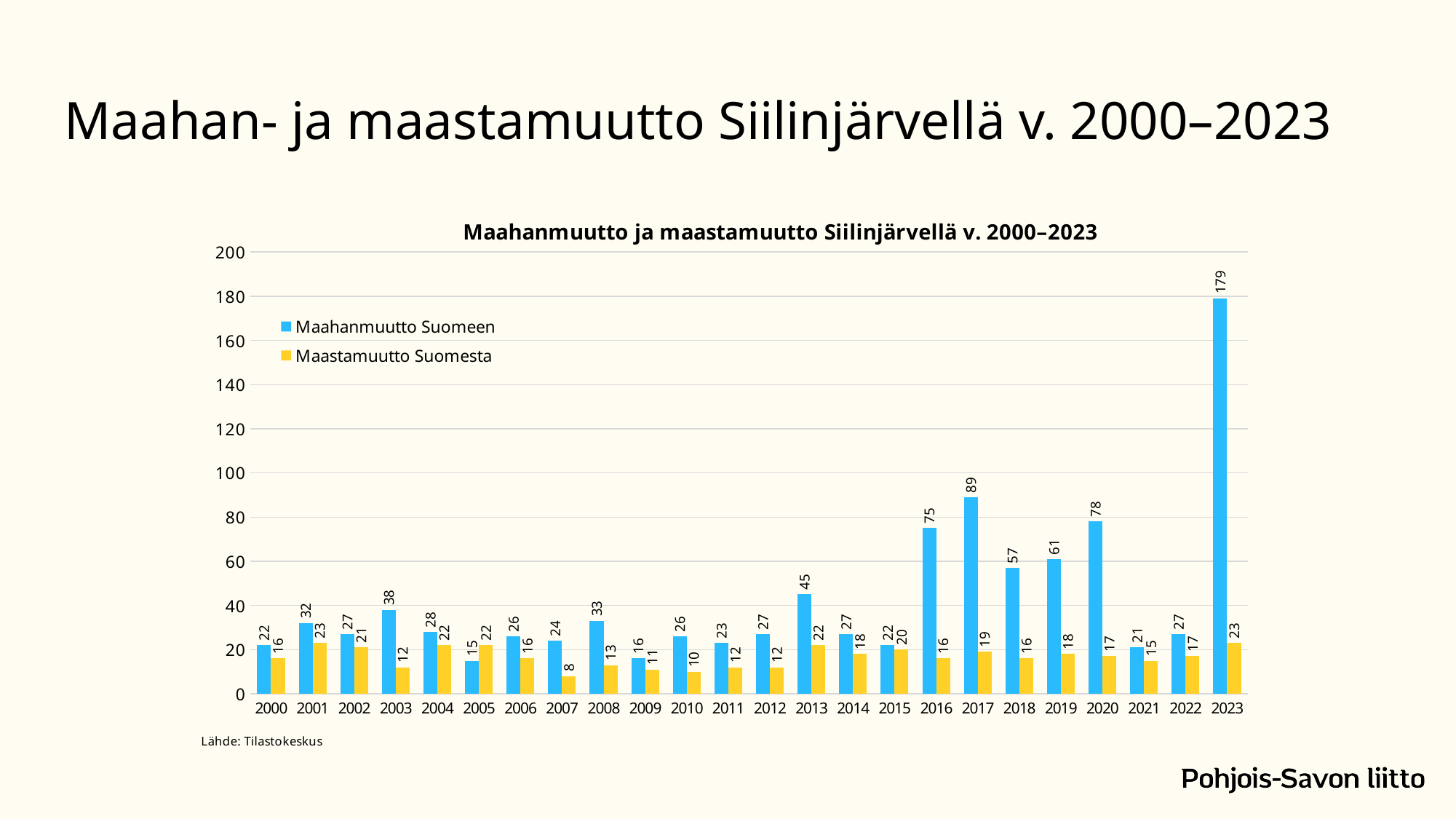
What is the difference between Maahanmuutto Suomeen and Maastamuutto Suomesta in 2023? 156 How many years are shown on the x axis? 24 Which year has the highest value for Maahanmuutto Suomeen? 2023 Which year has the lowest value for Maahanmuutto Suomeen? 2005 What is the value of Maastamuutto Suomesta for 2007? 8 What is the value of Maahanmuutto Suomeen for 2017? 89 How many series does the legend list? 2 What colour represents Maastamuutto Suomesta in the chart? Yellow Which year has the lowest value for Maastamuutto Suomesta? 2007 Which is larger in 2005: Maahanmuutto Suomeen or Maastamuutto Suomesta? Maastamuutto Suomesta What is the value of Maahanmuutto Suomeen for 2023? 179 What kind of chart is shown on the slide? Bar chart